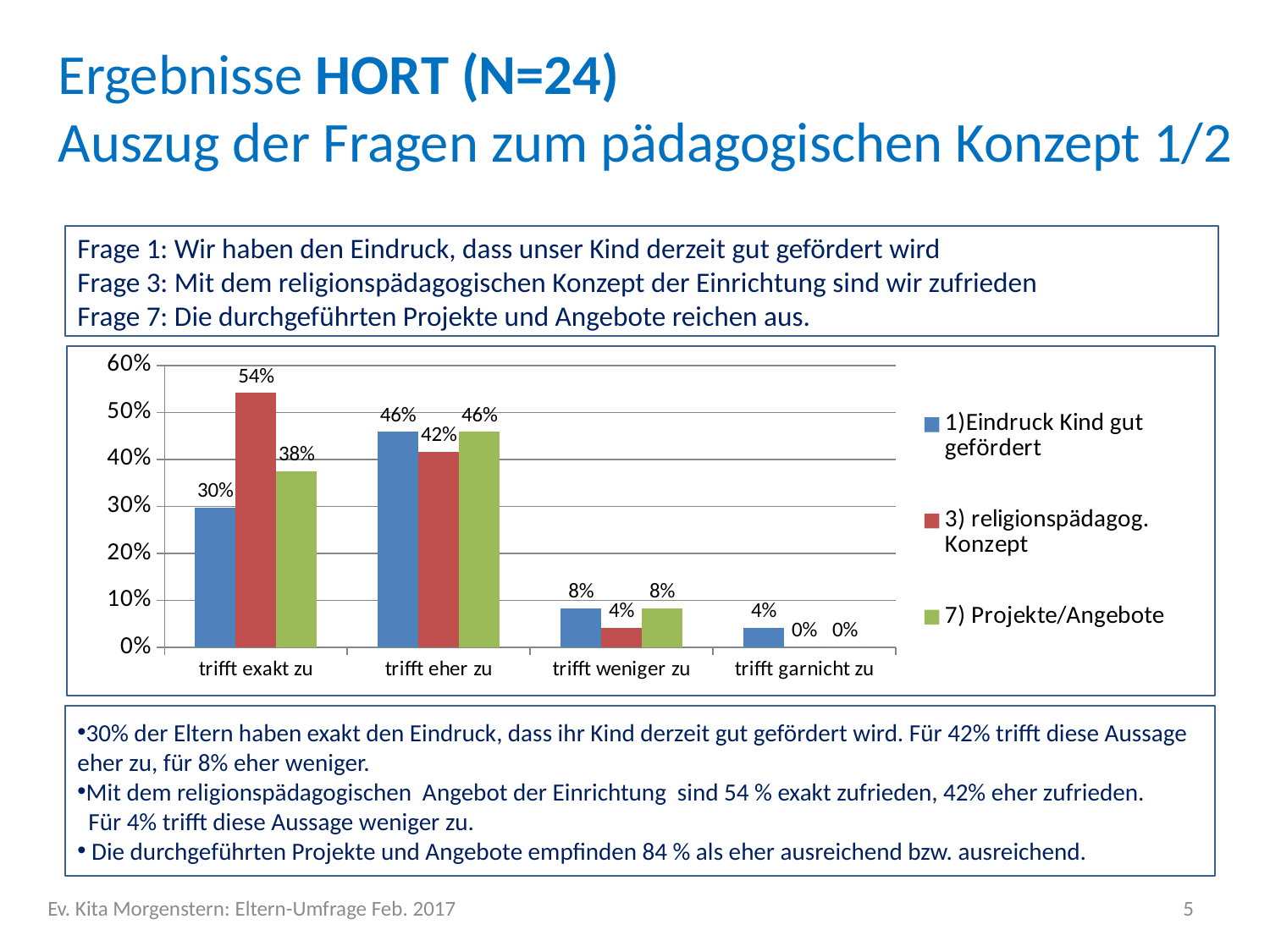
Which series has the lowest value in the category "trifft eher zu"? 3) religionspädagog. Konzept What is the value for "3) religionspädagog. Konzept" in the category "trifft exakt zu"? 54% Which series has the highest value in the category "trifft exakt zu"? 3) religionspädagog. Konzept Is the value for "7) Projekte/Angebote" in the category "trifft exakt zu" greater or less than 40%? less What is the value for "1)Eindruck Kind gut gefördert" in the category "trifft eher zu"? 46% What is the difference between the values for "3) religionspädagog. Konzept" and "1)Eindruck Kind gut gefördert" in the category "trifft exakt zu"? 24% How many categories are shown on the x axis? 4 In the category "trifft garnicht zu", which is larger: the value for "1)Eindruck Kind gut gefördert" or for "7) Projekte/Angebote"? 1)Eindruck Kind gut gefördert What kind of chart is shown on the slide? bar chart How many series does the legend list? 3 What colour are the bars for the series "7) Projekte/Angebote"? green What is the value for "7) Projekte/Angebote" in the category "trifft weniger zu"? 8%